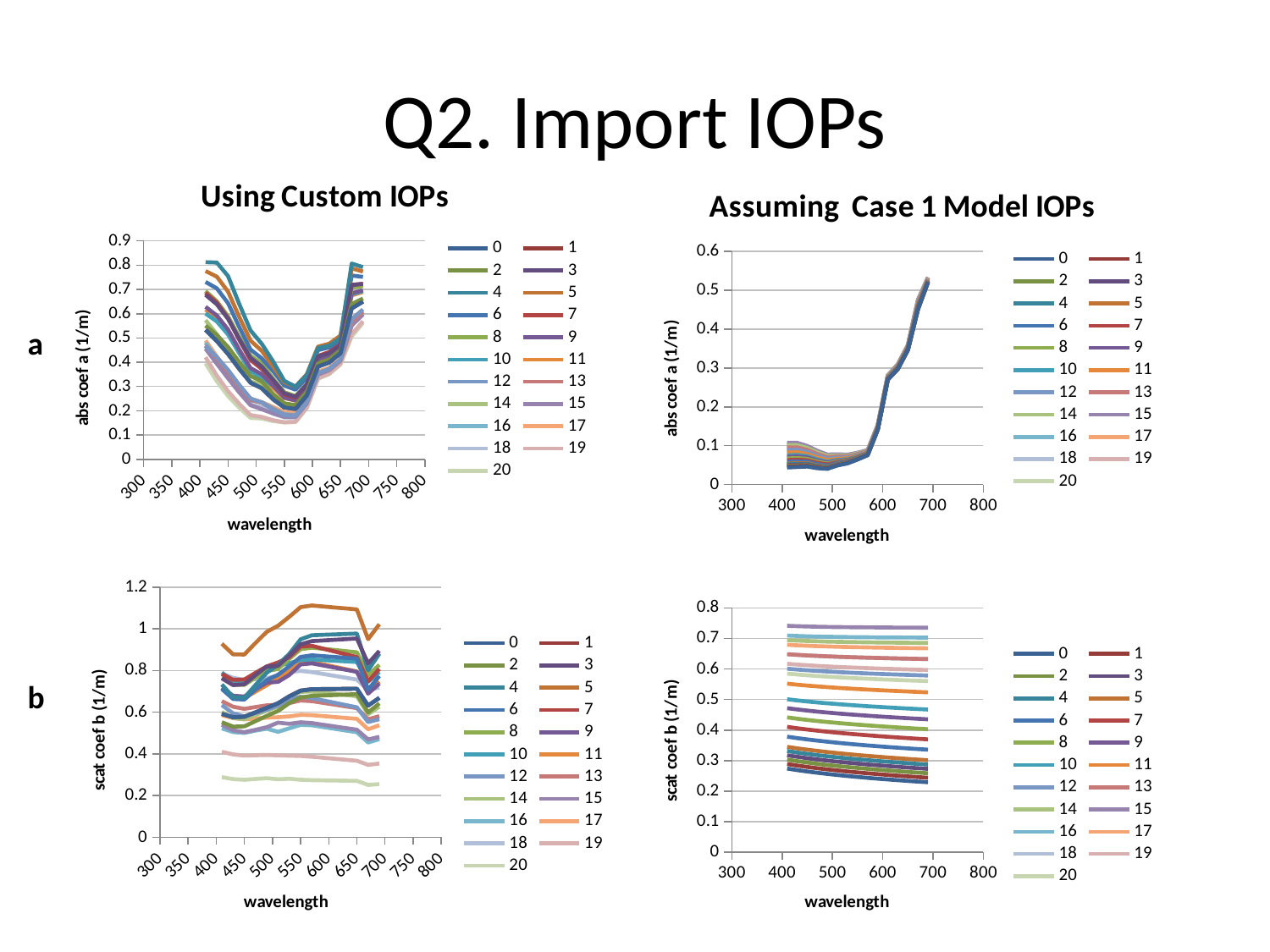
What is the title above the two right-hand charts? Assuming Case 1 Model IOPs In the bottom-left chart (scat coef b, Using Custom IOPs), is the peak value of series 5 greater or less than 1? greater What kind of chart is the top-left chart under 'Using Custom IOPs'? line chart In the bottom-left chart (scat coef b, Using Custom IOPs), which series has the lowest values? 20 In the bottom-left chart (scat coef b, Using Custom IOPs), which series has the highest values? 5 How many series does the legend of the top-right chart (abs coef a, Assuming Case 1 Model IOPs) list? 21 In the bottom-right chart (scat coef b, Assuming Case 1 Model IOPs), do the values rise or fall as wavelength increases? fall In the top-right chart (abs coef a, Assuming Case 1 Model IOPs), are the values at 700 nm greater or less than 0.4? greater What is the y-axis label of the bottom-left chart? scat coef b (1/m) In the bottom-right chart (scat coef b, Assuming Case 1 Model IOPs), is the value of series 20 at 700 nm greater or less than 0.3? greater In the top-left chart (abs coef a, Using Custom IOPs), do the values rise or fall as wavelength increases from 400 to 550? fall In the top-right chart (abs coef a, Assuming Case 1 Model IOPs), do the values rise or fall as wavelength increases from 500 to 700? rise